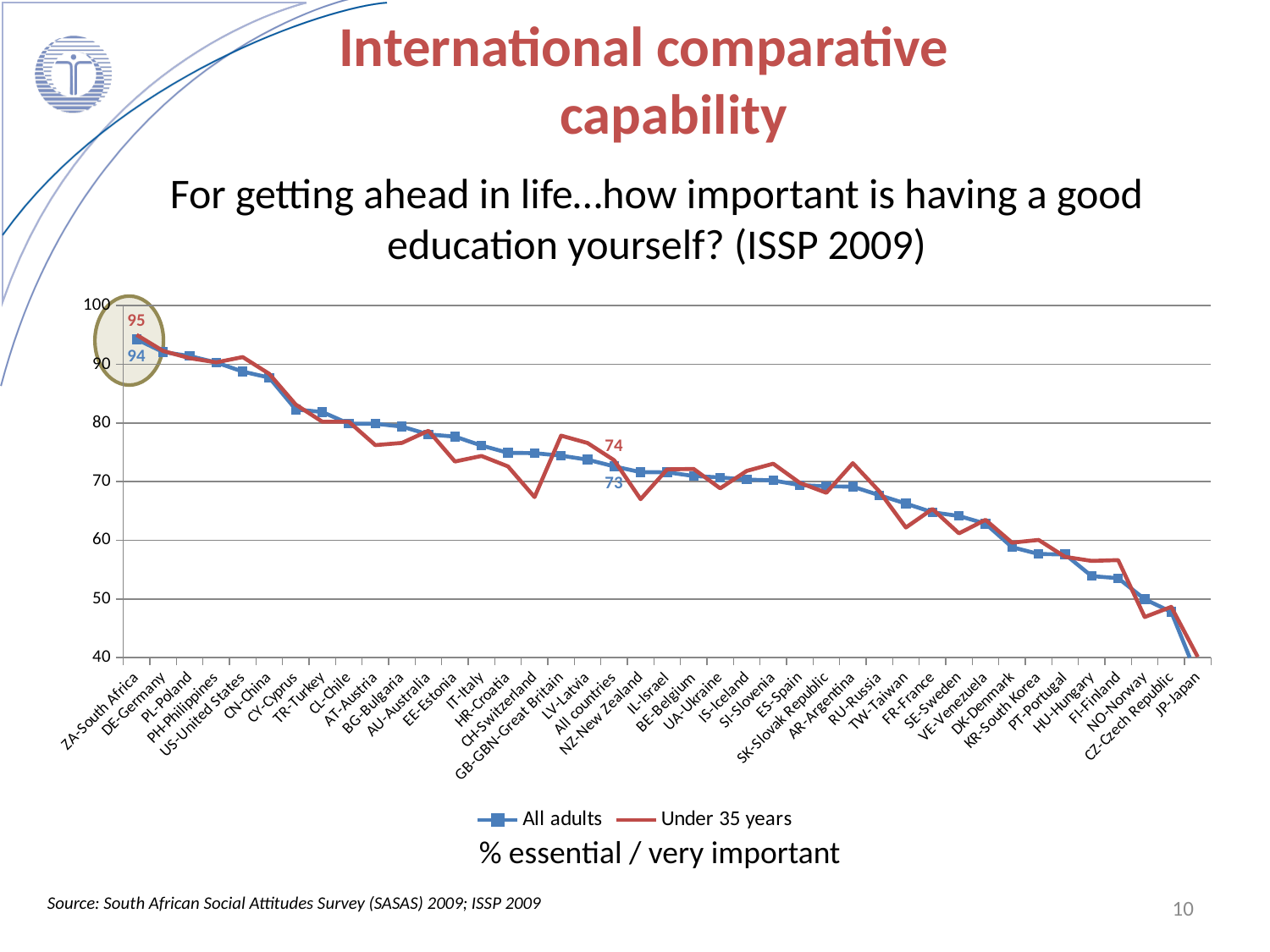
Which country has the highest value in the All adults series? ZA-South Africa What is the value for ZA-South Africa in the Under 35 years series? 95 What is the value for ZA-South Africa in the All adults series? 94 What is the value for All countries in the Under 35 years series? 74 Which country has the lowest value in the All adults series? JP-Japan What is the difference between the Under 35 years and All adults values for ZA-South Africa? 1 How many series does the legend list? 2 What is the value for All countries in the All adults series? 73 Is the All adults value for JP-Japan greater or less than 50? less Do the All adults values generally rise or fall moving from left to right along the x axis? fall What are the two series named in the legend? All adults; Under 35 years What kind of chart is shown on the slide? line chart